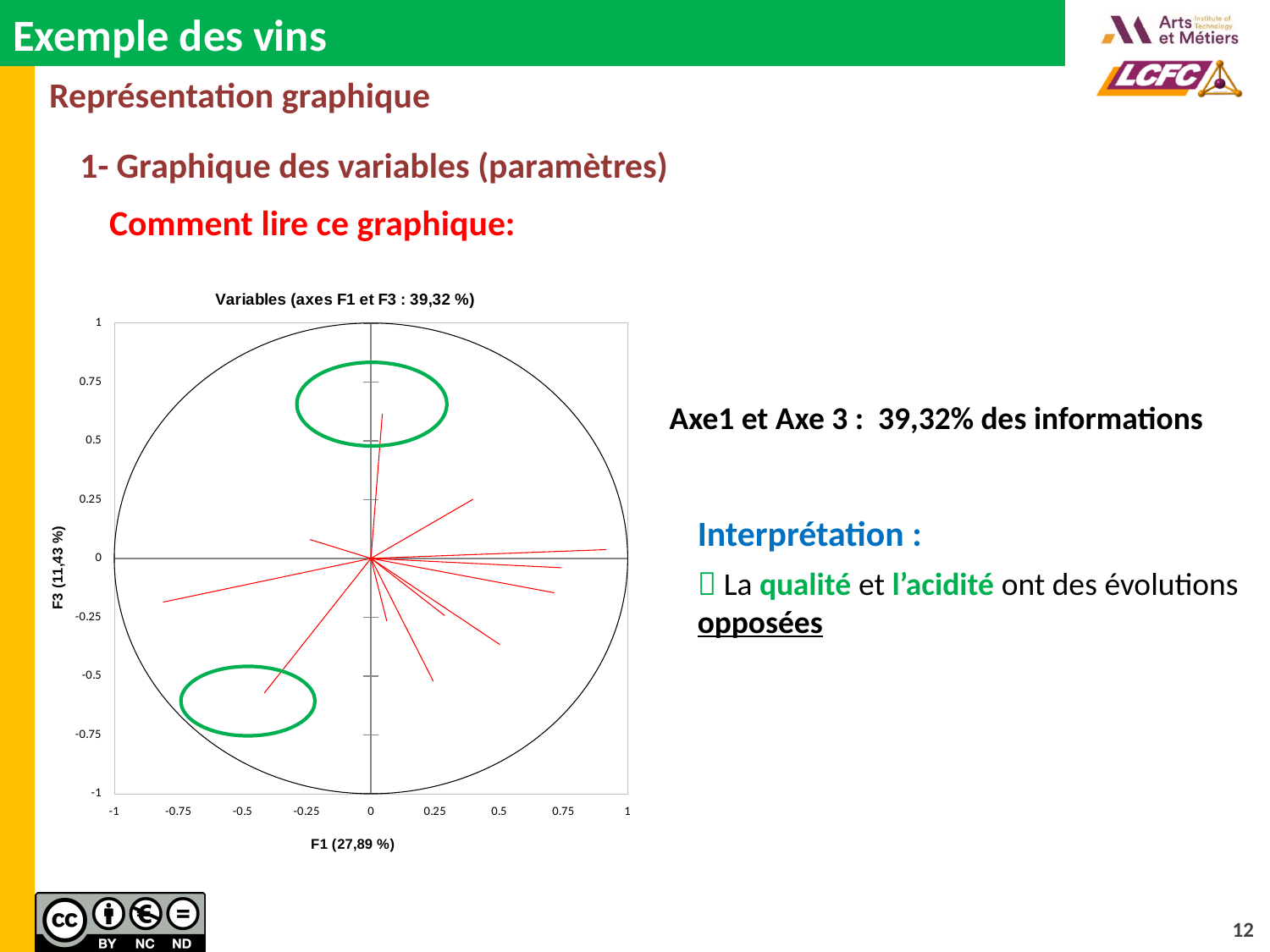
What is the label of the vertical axis of the chart? F3 (11,43 %) What total percentage of information do axes F1 and F3 together represent, as stated in the chart title? 39,32 % What is the title of the chart on the slide? Variables (axes F1 et F3 : 39,32 %) How many green ellipses are drawn on the chart? 2 What is the maximum value shown on the horizontal axis of the chart? 1 What is the label of the horizontal axis of the chart? F1 (27,89 %) Which axis of the chart carries a larger share of information, F1 or F3? F1 What percentage of information is carried by axis F1 according to the chart's x-axis label? 27,89 % What is the step between consecutive tick labels on the horizontal axis of the chart? 0.25 What percentage of information is carried by axis F3 according to the chart's y-axis label? 11,43 % What is the minimum value shown on the vertical axis of the chart? -1 What colour are the variable vectors drawn from the origin of the chart? Red